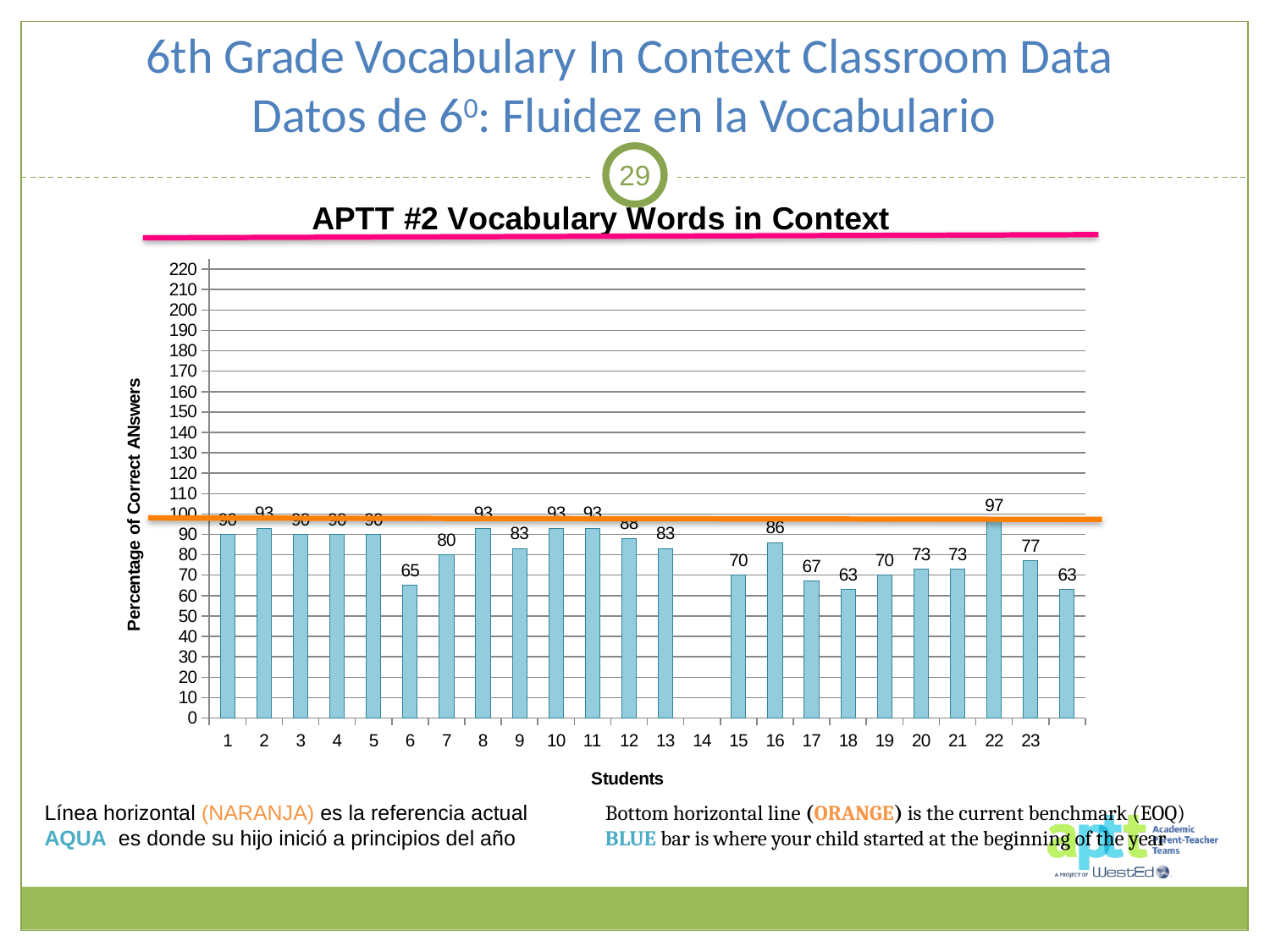
What is the value for student 6? 65 What kind of chart is shown on the slide? Bar chart What is the value for student 22? 97 Is the value for student 1 greater or less than 80? greater Which student has the highest percentage of correct answers? Student 22 What is the value for student 16? 86 What is the value for student 23? 77 What is the difference between the values for student 20 and student 19? 3 What is the difference between the values for student 22 and student 6? 32 What does the orange horizontal line on the chart represent? The current benchmark (EOQ) How many student numbers are labelled on the x axis? 23 Which has a larger value, student 16 or student 17? Student 16